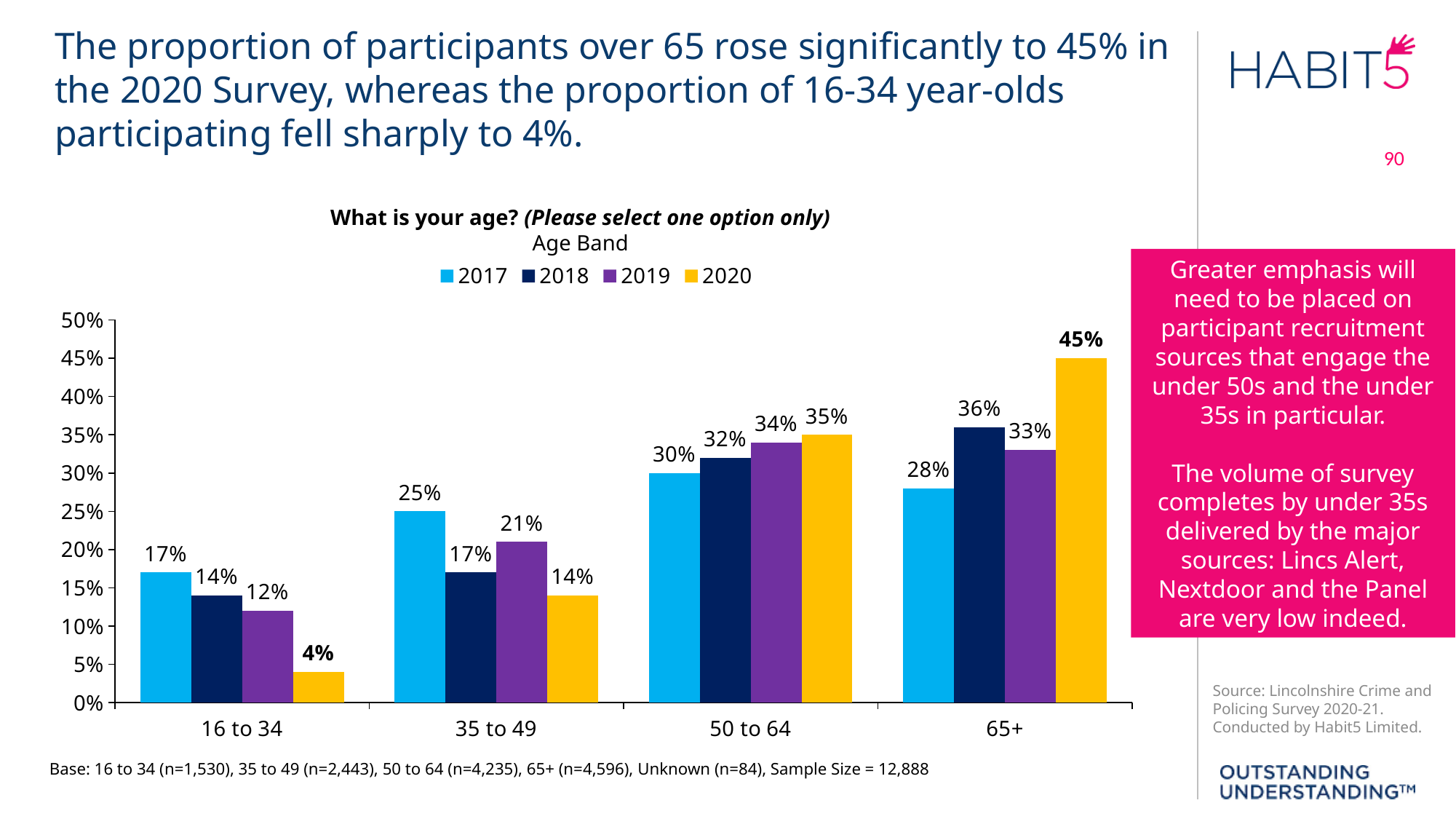
Which colour represents the 2020 series in the legend? Yellow Which is larger for the 35 to 49 age band: the 2019 value or the 2020 value? 2019 What is the 2019 value for the 50 to 64 age band? 34% Which age band has the lowest 2020 value? 16 to 34 What is the difference between the 2020 and 2017 values for the 65+ age band? 17% Which age band has the highest 2018 value? 65+ How many age bands are shown on the x axis? 4 Do the 2020 values rise or fall from the 16 to 34 band to the 65+ band? Rise How many series does the legend list? 4 What kind of chart is shown? Bar chart What is the 2020 value for the 65+ age band? 45% What is the 2017 value for the 35 to 49 age band? 25%